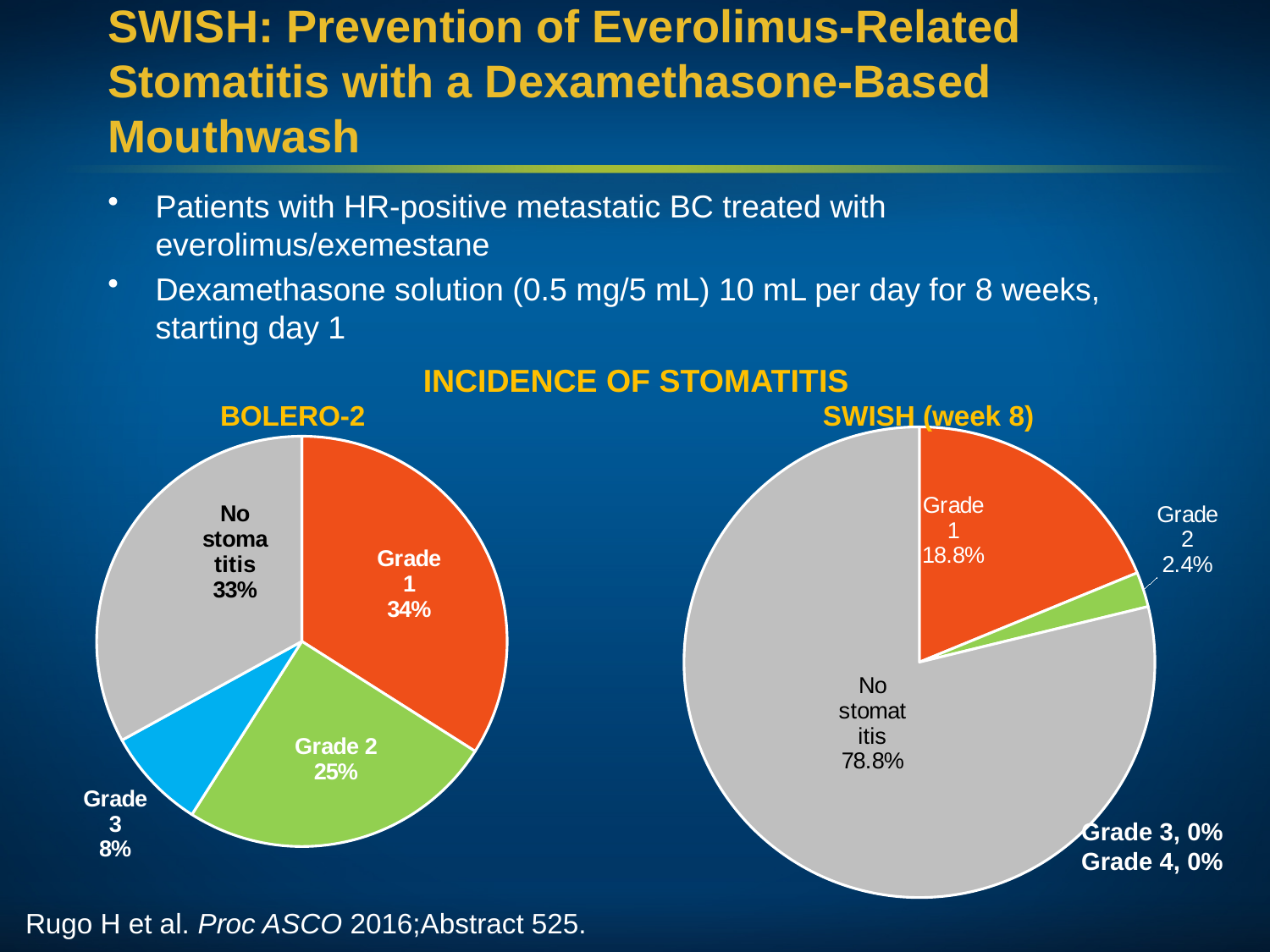
In the SWISH (week 8) pie chart, what percentage of patients had no stomatitis? 78.8% In the BOLERO-2 pie chart, what is the difference in percentage points between Grade 1 and Grade 2 stomatitis? 9 percentage points In the SWISH (week 8) pie chart, what percentage of patients had Grade 2 stomatitis? 2.4% In the BOLERO-2 pie chart, which category has the smallest share? Grade 3 In the SWISH (week 8) pie chart, what is the difference in percentage points between no stomatitis and Grade 1 stomatitis? 60 percentage points In the BOLERO-2 pie chart, what percentage of patients had no stomatitis? 33% In the SWISH (week 8) pie chart, what percentage of patients had Grade 3 stomatitis? 0% Which chart shows a larger share of patients with no stomatitis, BOLERO-2 or SWISH (week 8)? SWISH (week 8) In the BOLERO-2 pie chart, what percentage of patients had Grade 1 stomatitis? 34% How many slices does the BOLERO-2 pie chart have? 4 In the SWISH (week 8) pie chart, which category has the largest share? No stomatitis What type of chart is used to show the incidence of stomatitis on this slide? Pie chart